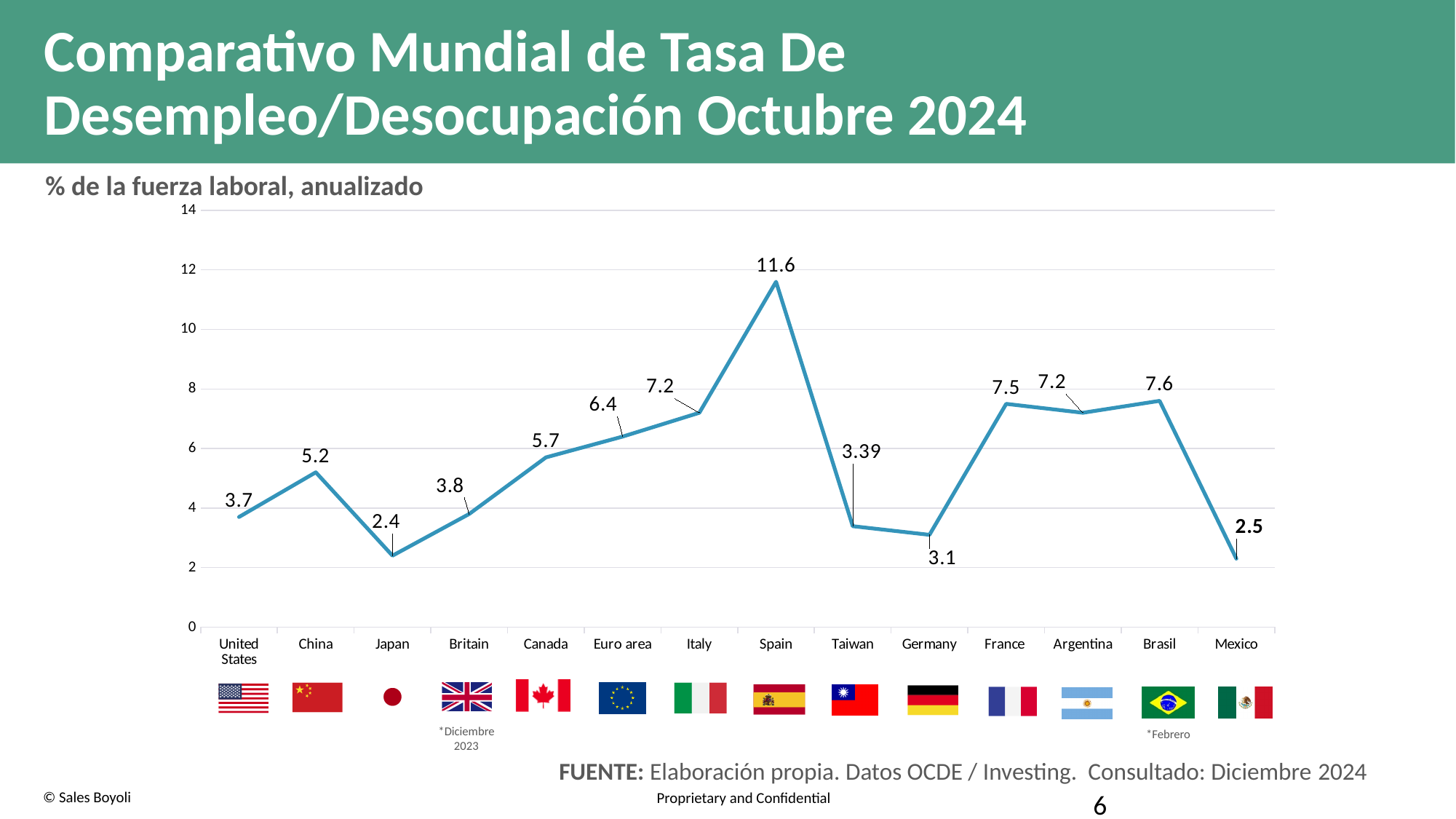
What is the difference between the values for Spain and Japan? 9.2 Is the value for Italy greater or less than 6? greater What is the unemployment rate shown for Spain? 11.6 What type of chart is shown on the slide? Line chart What is the value shown for Mexico? 2.5 What is the value plotted for Taiwan? 3.39 What is the difference between the values for Brasil and France? 0.1 Which country has the highest unemployment rate on the chart? Spain What is the subtitle describing the unit of the chart? % de la fuerza laboral, anualizado How many countries or regions are plotted on the chart? 14 Which has a higher value, China or Canada? Canada